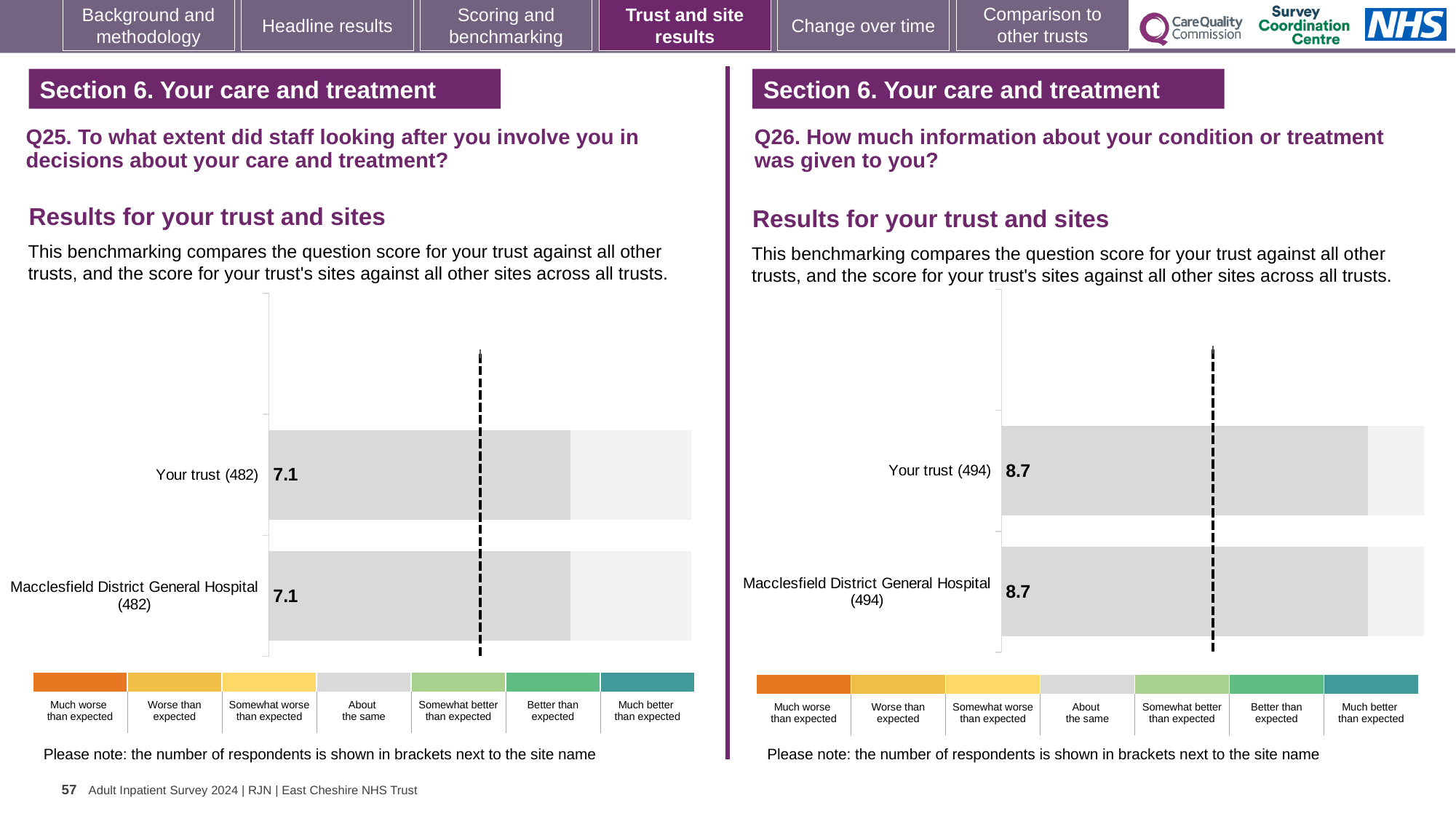
On the Q26 chart (right), how many respondents are shown in brackets for Macclesfield District General Hospital? 494 On the Q26 chart (right), what is the difference between the score for Your trust and the score for Macclesfield District General Hospital? 0 On the Q25 chart (left), what is the difference between the score for Your trust and the score for Macclesfield District General Hospital? 0 On the Q25 chart (left), how many respondents are shown in brackets for Your trust? 482 On the Q25 chart (left), what is the score for Macclesfield District General Hospital? 7.1 Is the score for Your trust on the Q26 chart (right) larger or smaller than the score for Your trust on the Q25 chart (left)? Larger How many bars are plotted on the Q25 chart (left)? 2 On the Q26 chart (right), what is the score for Macclesfield District General Hospital? 8.7 What kind of chart is used on the Q26 chart (right)? Bar chart On the Q25 chart (left), what is the score for Your trust? 7.1 How many bars are plotted on the Q26 chart (right)? 2 On the Q26 chart (right), what is the score for Your trust? 8.7